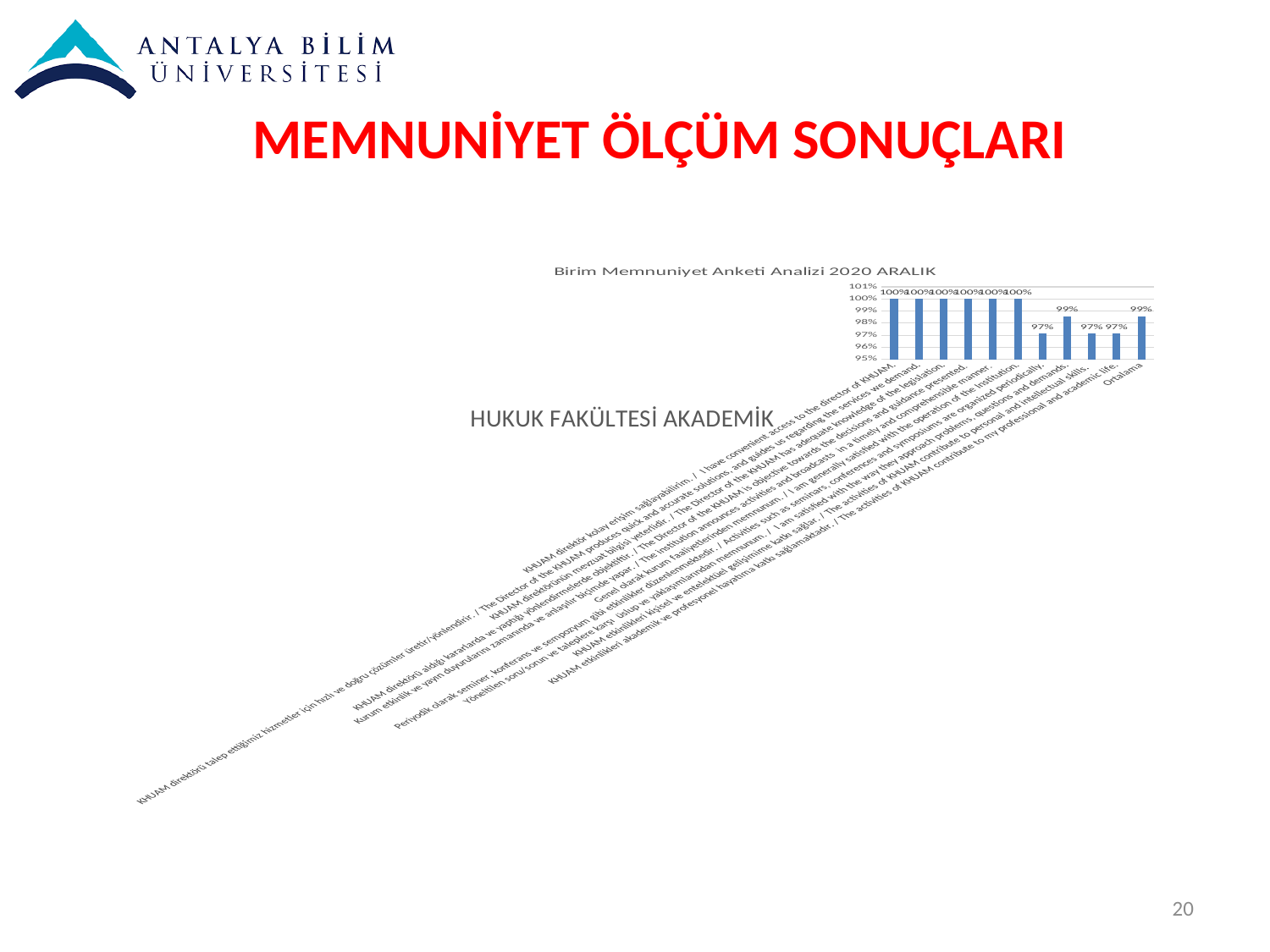
Which is larger: the value of the first bar (100%) or the value of the 'Ortalama' bar (99%)? the first bar What is the value shown for the 'Ortalama' category? 99% What is the lowest value shown on the vertical axis of the chart? 95% What is the highest value shown by any bar in the chart? 100% What is the lowest value shown by any bar in the chart? 97% What is the value of the first bar on the left of the chart? 100% How many bars are plotted in the chart? 11 What type of chart is shown on the slide? bar chart What is the difference between the highest bar value (100%) and the lowest bar value (97%)? 3% What is the title of the chart? Birim Memnuniyet Anketi Analizi 2020 ARALIK How many bars in the chart have a value of 100%? 6 Is the value for the 'Ortalama' category greater or less than 98%? greater